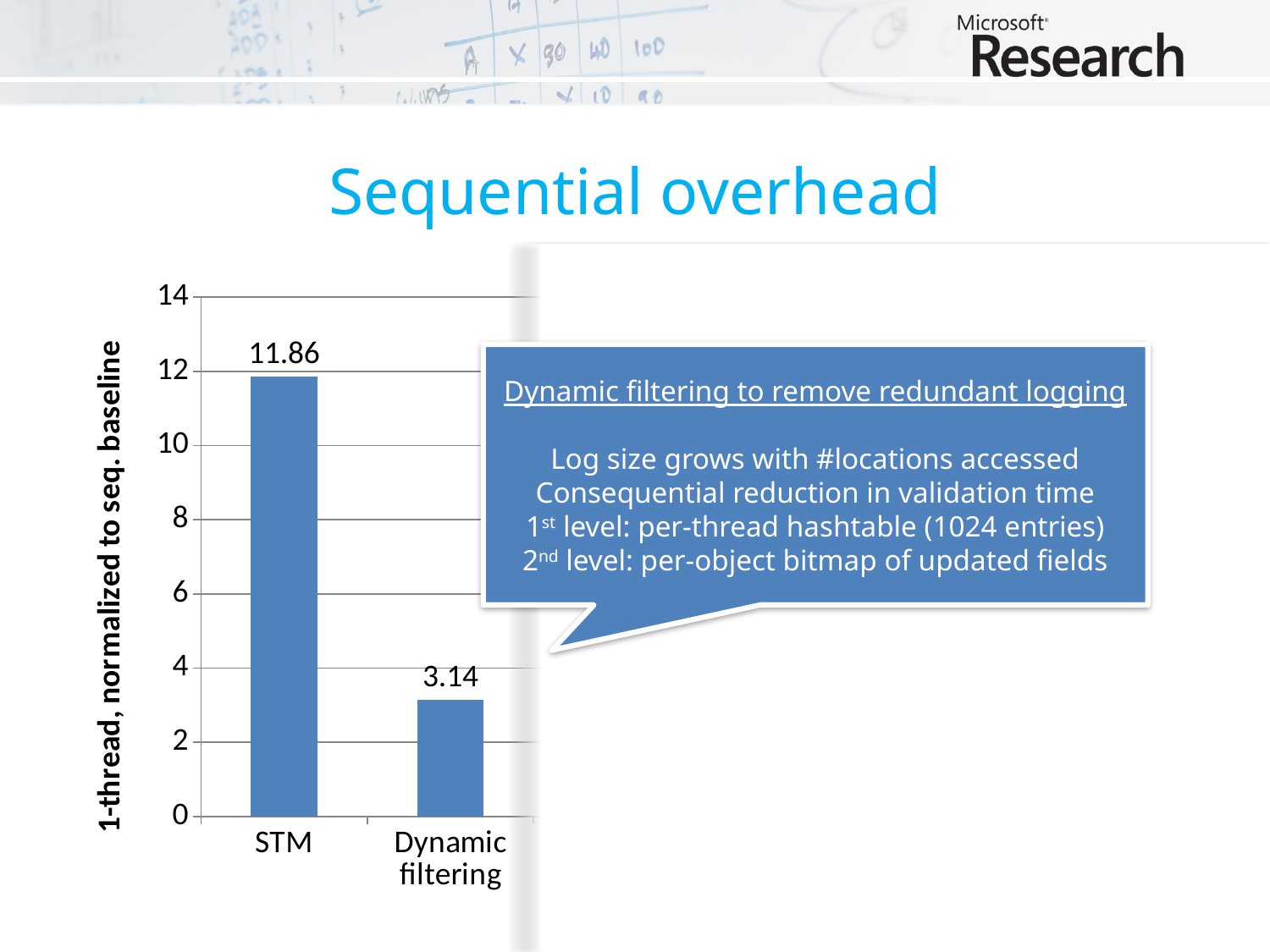
What is the maximum value shown on the y axis? 14 What is the value for STM? 11.86 Which category has the lowest value? Dynamic filtering What is the label of the y axis? 1-thread, normalized to seq. baseline Is the value for STM greater or less than 10? greater Is the value for Dynamic filtering greater or less than 4? less What kind of chart is shown on the slide? bar chart Which category has the highest value? STM What is the difference between the STM value and the Dynamic filtering value? 8.72 Which is larger, the value for STM or the value for Dynamic filtering? STM How many categories are shown on the x axis? 2 What is the value for Dynamic filtering? 3.14